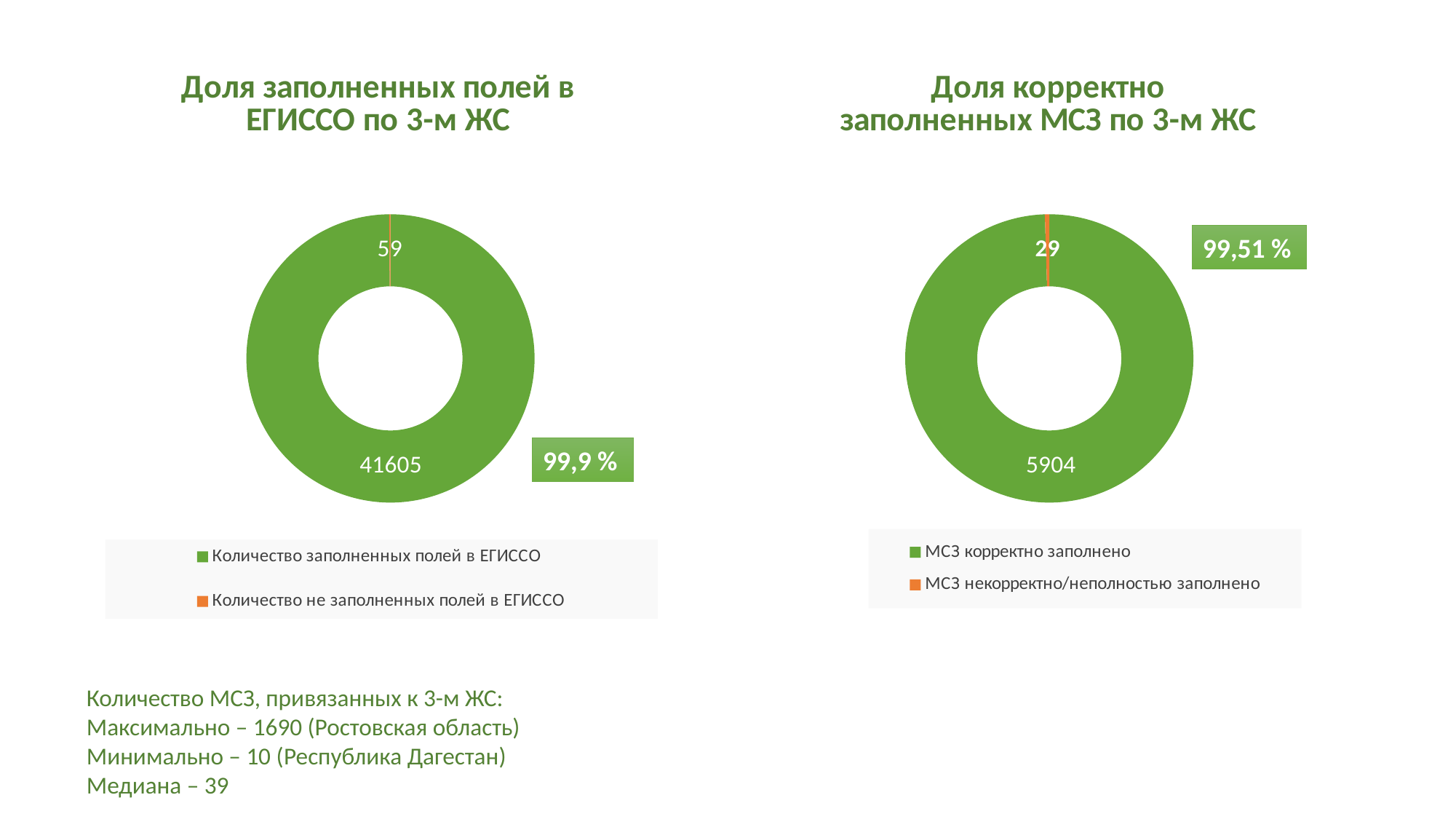
In the left chart 'Доля заполненных полей в ЕГИССО по 3-м ЖС', what is the value for 'Количество заполненных полей в ЕГИССО'? 41605 In the left chart 'Доля заполненных полей в ЕГИССО по 3-м ЖС', what is the value for 'Количество не заполненных полей в ЕГИССО'? 59 In the left chart 'Доля заполненных полей в ЕГИССО по 3-м ЖС', what share of the chart does 'Количество заполненных полей в ЕГИССО' represent, as printed on the slide? 99,9 % What kind of chart is the left chart 'Доля заполненных полей в ЕГИССО по 3-м ЖС'? doughnut chart In the left chart 'Доля заполненных полей в ЕГИССО по 3-м ЖС', what is the difference between the filled and not filled field counts? 41546 In the right chart 'Доля корректно заполненных МСЗ по 3-м ЖС', what share does 'МСЗ корректно заполнено' represent, as printed on the slide? 99,51 % How many categories does the legend of the right chart 'Доля корректно заполненных МСЗ по 3-м ЖС' list? 2 In the left chart 'Доля заполненных полей в ЕГИССО по 3-м ЖС', which category has the largest value? Количество заполненных полей в ЕГИССО In the right chart 'Доля корректно заполненных МСЗ по 3-м ЖС', which category has the smallest value? МСЗ некорректно/неполностью заполнено In the right chart 'Доля корректно заполненных МСЗ по 3-м ЖС', what is the total of the two categories? 5933 In the right chart 'Доля корректно заполненных МСЗ по 3-м ЖС', what is the value for 'МСЗ некорректно/неполностью заполнено'? 29 In the right chart 'Доля корректно заполненных МСЗ по 3-м ЖС', what is the value for 'МСЗ корректно заполнено'? 5904